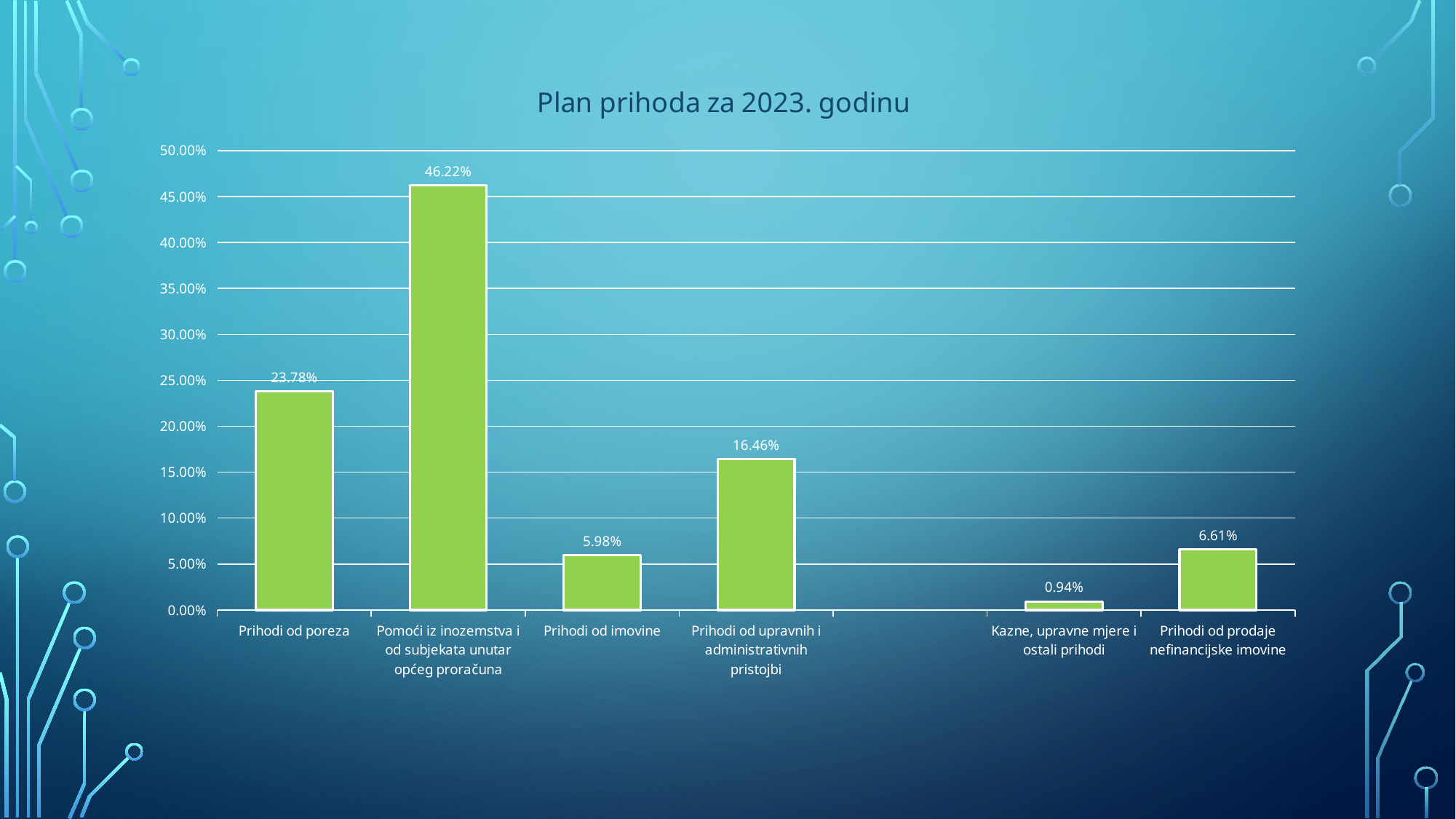
What is the value for Pomoći iz inozemstva i od subjekata unutar općeg proračuna? 46.22% Which category has the highest value? Pomoći iz inozemstva i od subjekata unutar općeg proračuna Is the value for Prihodi od poreza greater or less than 20.00%? greater What is the value for Prihodi od poreza? 23.78% What kind of chart is shown on the slide? bar chart Which category has the lowest value? Kazne, upravne mjere i ostali prihodi What is the value for Prihodi od upravnih i administrativnih pristojbi? 16.46% What is the value for Kazne, upravne mjere i ostali prihodi? 0.94% What is the difference between the values for Pomoći iz inozemstva i od subjekata unutar općeg proračuna and Prihodi od poreza? 22.44% What is the title of the chart? Plan prihoda za 2023. godinu What is the difference between the values for Prihodi od upravnih i administrativnih pristojbi and Prihodi od imovine? 10.48% Which is larger, the value for Prihodi od prodaje nefinancijske imovine or the value for Prihodi od imovine? Prihodi od prodaje nefinancijske imovine